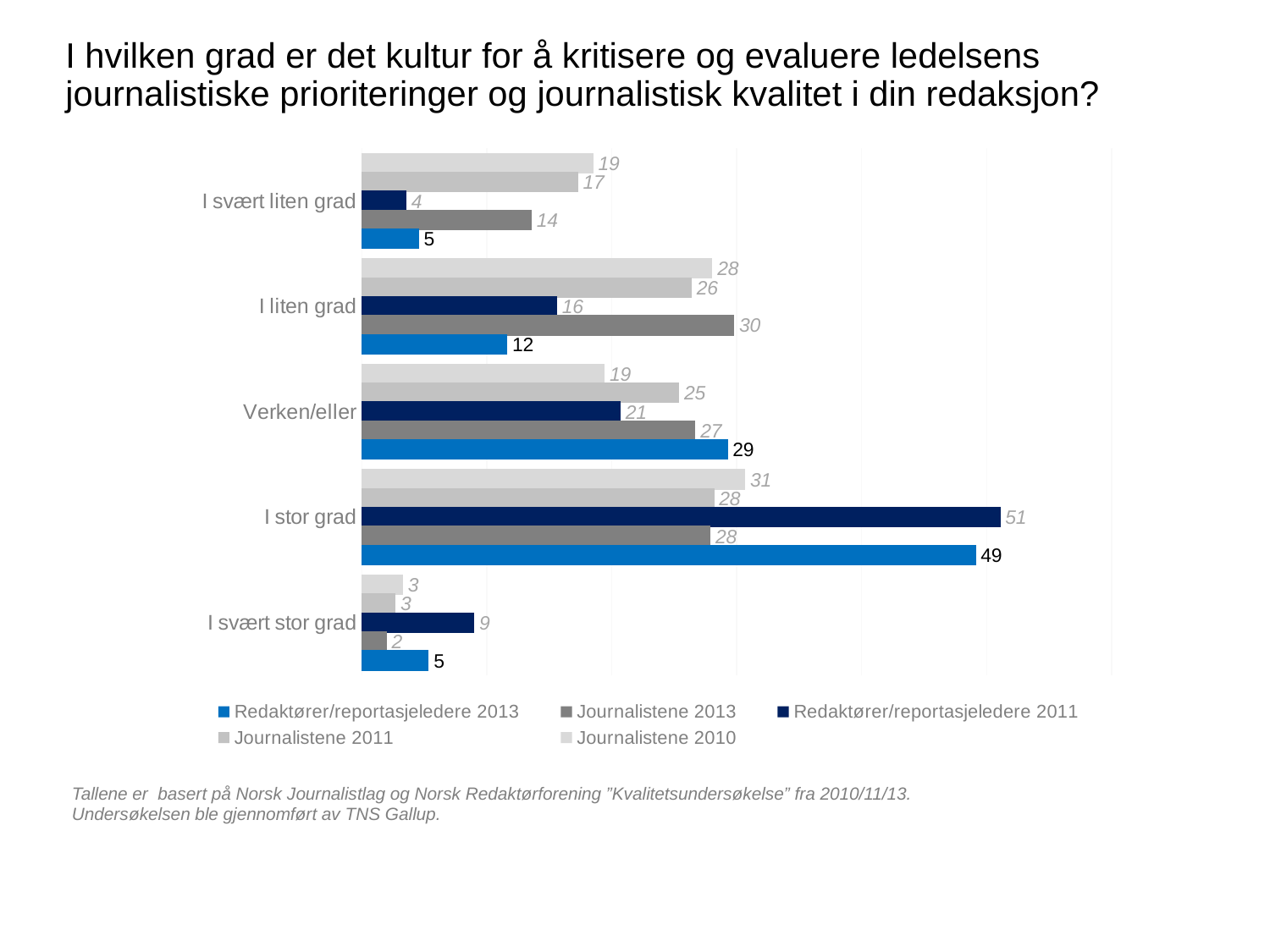
What is the value for Redaktører/reportasjeledere 2011 in the 'I stor grad' category? 51 How many categories are shown on the chart? 5 What is the value for Redaktører/reportasjeledere 2013 in the 'I stor grad' category? 49 How many series does the legend list? 5 What kind of chart is shown on the slide? Bar chart What is the difference between the Redaktører/reportasjeledere 2011 and Redaktører/reportasjeledere 2013 values in the 'I stor grad' category? 2 Which category has the highest value for Redaktører/reportasjeledere 2013? I stor grad Which category has the lowest value for Journalistene 2013? I svært stor grad What is the value for Redaktører/reportasjeledere 2013 in the 'Verken/eller' category? 29 What is the value for Journalistene 2013 in the 'I liten grad' category? 30 In the 'I liten grad' category, which is larger: Journalistene 2013 or Redaktører/reportasjeledere 2013? Journalistene 2013 Which series is shown in the darkest navy colour in the legend? Redaktører/reportasjeledere 2011